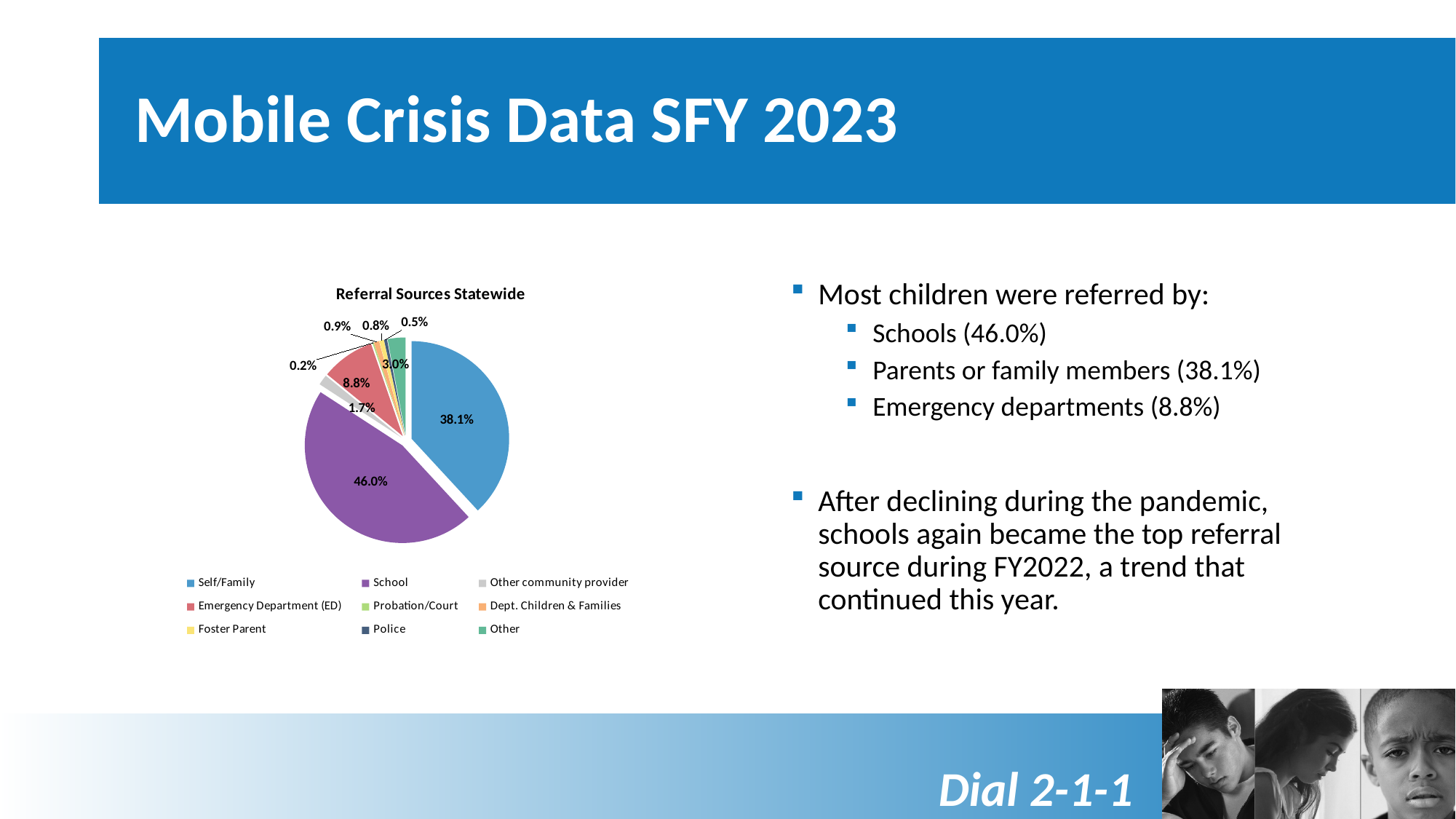
What share of referrals came from Emergency Department (ED)? 8.8% Which referral source has the largest slice of the pie? School What is the title of the chart? Referral Sources Statewide How many referral source categories does the legend list? 9 What share of referrals came from the Other category? 3.0% Which is larger, the share for School or the share for Self/Family? School What colour is the School slice in the pie chart? purple What share of referrals came from Self/Family? 38.1% What is the difference between the School share and the Self/Family share? 7.9% What share of referrals came from School? 46.0% What share of referrals came from Other community provider? 1.7% What type of chart is shown on the slide? pie chart